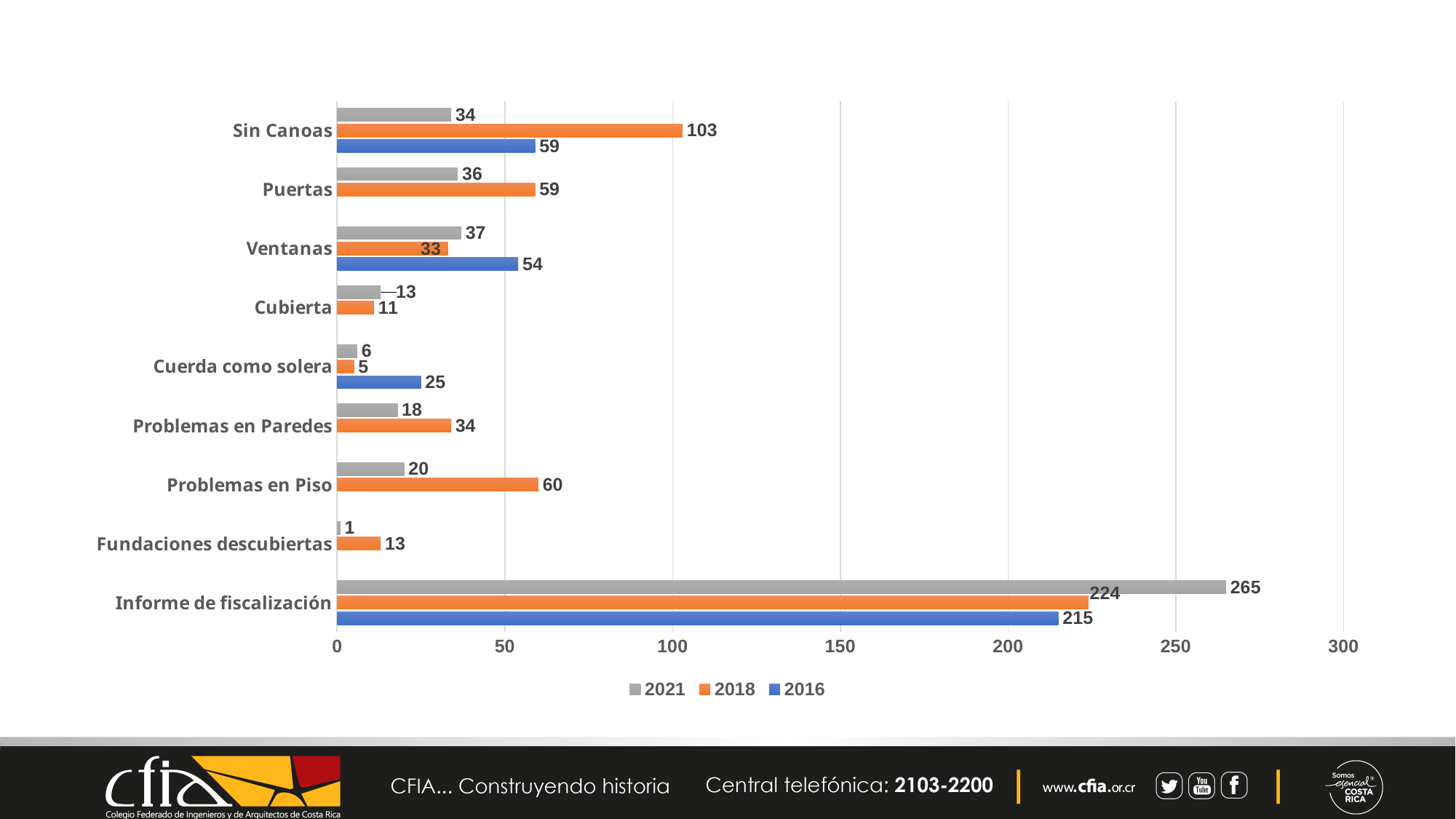
What is the difference between the 2021 and 2018 values for Informe de fiscalización? 41 Which is larger for Ventanas, the 2016 value or the 2018 value? 2016 Which category has the highest 2021 value? Informe de fiscalización How many series does the legend list? 3 What is the 2016 value for Informe de fiscalización? 215 Which category has the lowest 2018 value? Cuerda como solera How many categories are shown on the chart? 9 What kind of chart is shown on the slide? Bar chart What is the 2021 value for Fundaciones descubiertas? 1 What is the difference between the 2018 and 2021 values for Problemas en Piso? 40 What is the 2018 value for Sin Canoas? 103 Which colour represents the 2016 series in the legend? Blue